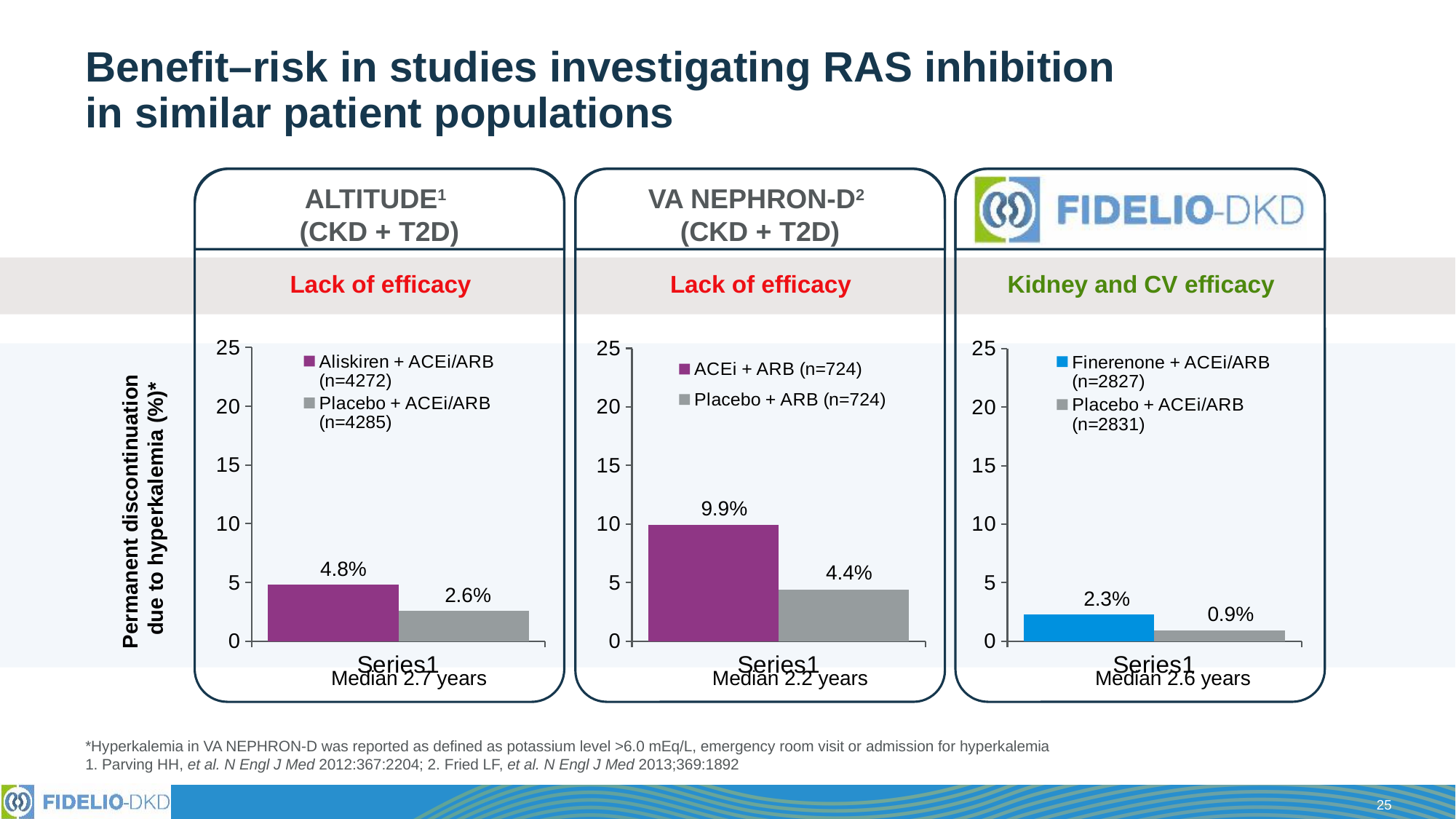
In the FIDELIO-DKD chart, what is the value for Finerenone + ACEi/ARB? 2.3% In the FIDELIO-DKD chart, what is the value for Placebo + ACEi/ARB? 0.9% In the VA NEPHRON-D chart, what is the difference between the ACEi + ARB and Placebo + ARB values? 5.5% What type of chart is used in the ALTITUDE panel? Bar chart In the VA NEPHRON-D chart, what is the value for ACEi + ARB? 9.9% How many series does the legend of the FIDELIO-DKD chart list? 2 In the VA NEPHRON-D chart, is the value for ACEi + ARB greater or less than 5? greater In the ALTITUDE chart, what is the permanent discontinuation rate due to hyperkalemia for Aliskiren + ACEi/ARB? 4.8% In the ALTITUDE chart, what is the value for Placebo + ACEi/ARB? 2.6% In the VA NEPHRON-D chart, what is the value for Placebo + ARB? 4.4% In the FIDELIO-DKD chart, which series has the higher value, Finerenone + ACEi/ARB or Placebo + ACEi/ARB? Finerenone + ACEi/ARB In the ALTITUDE chart, what is the difference between the Aliskiren + ACEi/ARB and Placebo + ACEi/ARB values? 2.2%